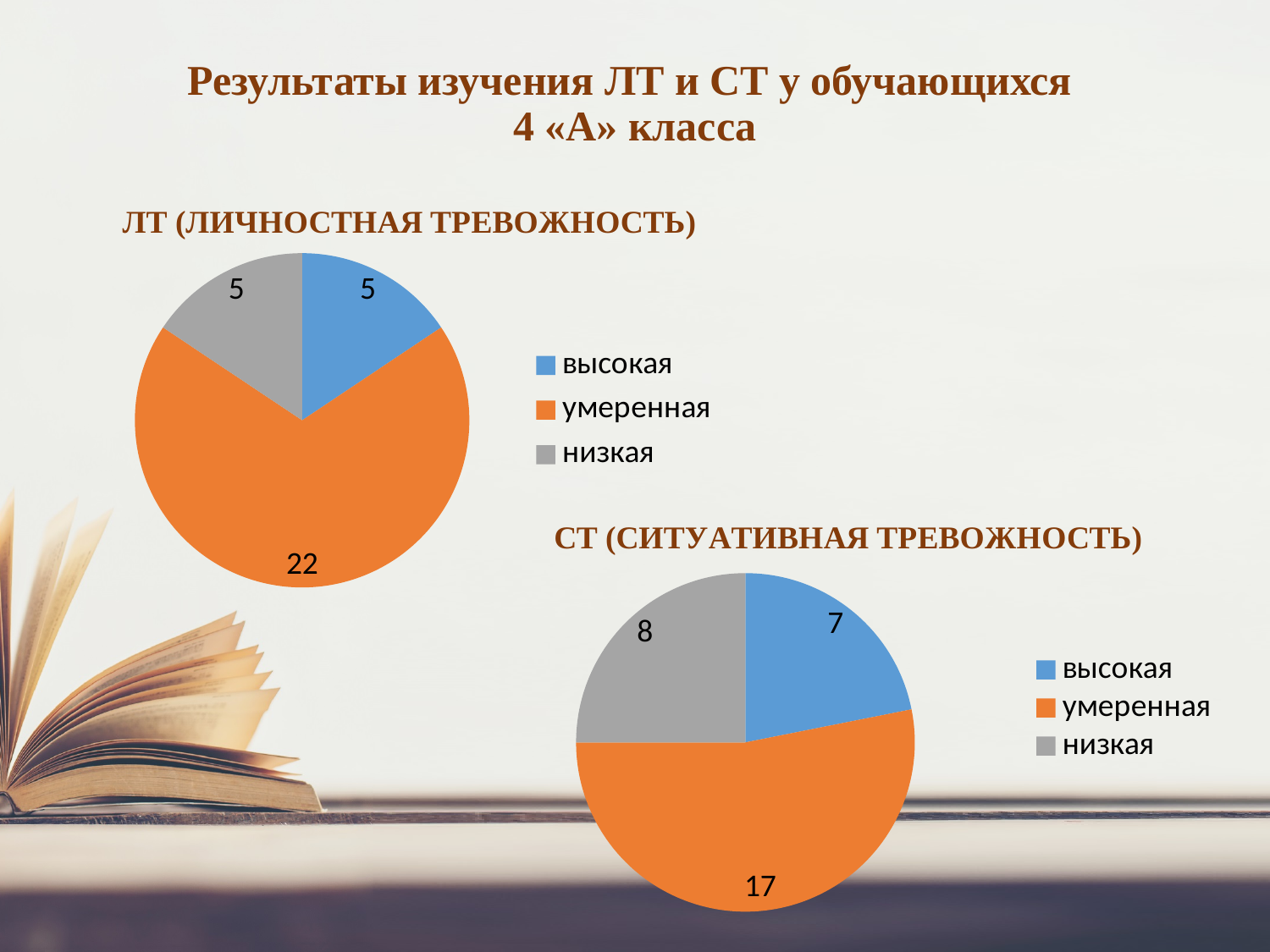
In the СТ (СИТУАТИВНАЯ ТРЕВОЖНОСТЬ) chart, what is the value for высокая? 7 Which is larger: умеренная in the ЛТ chart or умеренная in the СТ chart? умеренная in the ЛТ chart What type of chart is the СТ (СИТУАТИВНАЯ ТРЕВОЖНОСТЬ) chart? Pie chart In the СТ (СИТУАТИВНАЯ ТРЕВОЖНОСТЬ) chart, which category has the smallest slice? высокая In the ЛТ (ЛИЧНОСТНАЯ ТРЕВОЖНОСТЬ) chart, what is the value for низкая? 5 How many categories does the ЛТ (ЛИЧНОСТНАЯ ТРЕВОЖНОСТЬ) chart show? 3 In the СТ (СИТУАТИВНАЯ ТРЕВОЖНОСТЬ) chart, what share of the total does низкая represent? 25% In the СТ (СИТУАТИВНАЯ ТРЕВОЖНОСТЬ) chart, what is the value for низкая? 8 In the ЛТ (ЛИЧНОСТНАЯ ТРЕВОЖНОСТЬ) chart, what is the value for умеренная? 22 In the СТ (СИТУАТИВНАЯ ТРЕВОЖНОСТЬ) chart, what is the difference between умеренная and низкая? 9 In the ЛТ (ЛИЧНОСТНАЯ ТРЕВОЖНОСТЬ) chart, which category has the largest slice? умеренная In the ЛТ (ЛИЧНОСТНАЯ ТРЕВОЖНОСТЬ) chart, what is the difference between умеренная and высокая? 17